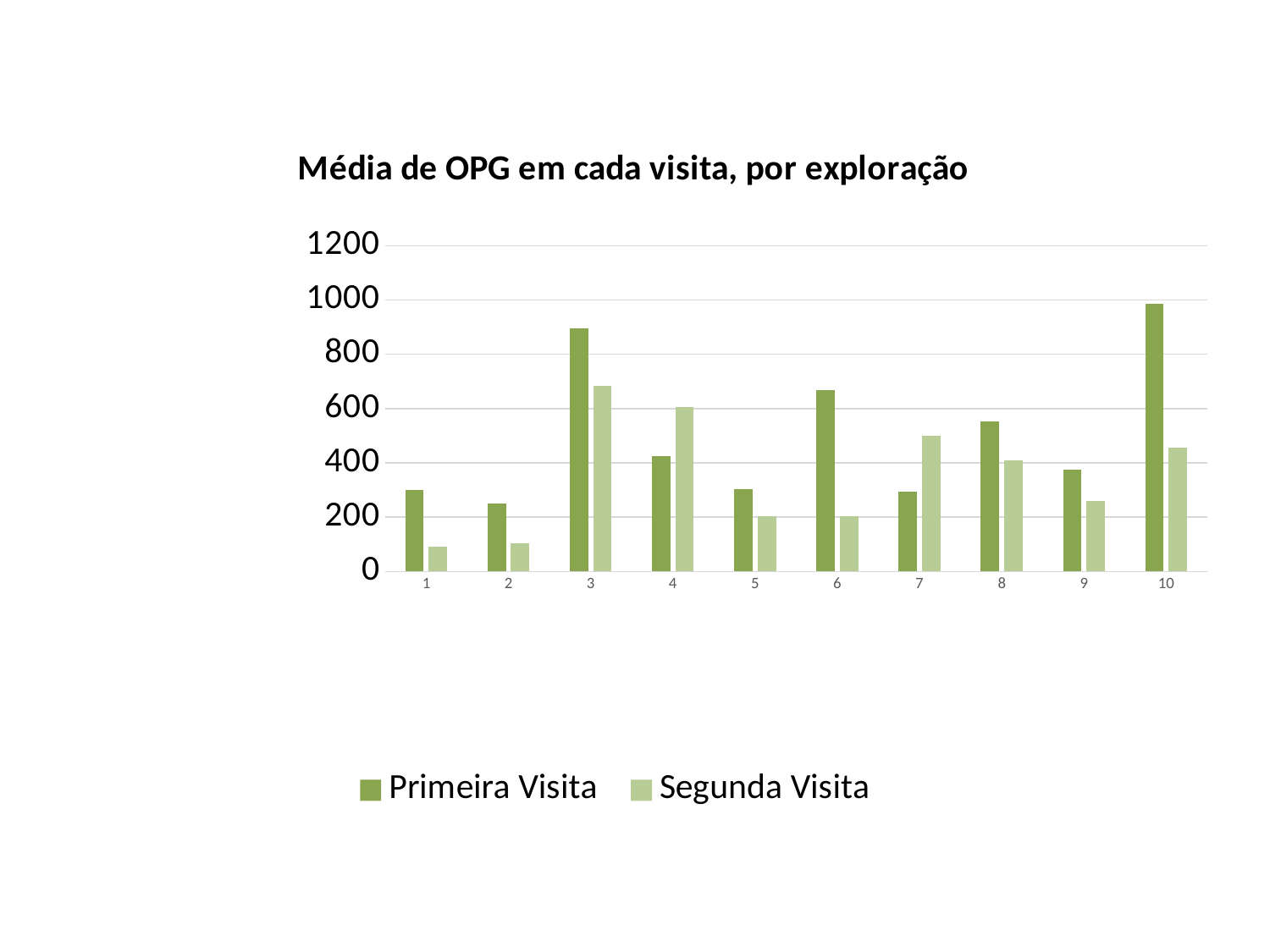
How many explorações (categories) are shown on the x axis? 10 For exploração 4, which series has the larger value, Primeira Visita or Segunda Visita? Segunda Visita How many series does the legend list? 2 What kind of chart is shown on the slide? bar chart Is the Segunda Visita value for exploração 1 greater or less than 200? less Which exploração has the highest Segunda Visita value? 3 Is the Primeira Visita value for exploração 10 greater or less than 800? greater Which exploração has the highest Primeira Visita value? 10 Is the Primeira Visita value for exploração 3 greater or less than 800? greater What is the title of the chart? Média de OPG em cada visita, por exploração What are the two series named in the legend? Primeira Visita and Segunda Visita For exploração 6, which series has the larger value, Primeira Visita or Segunda Visita? Primeira Visita